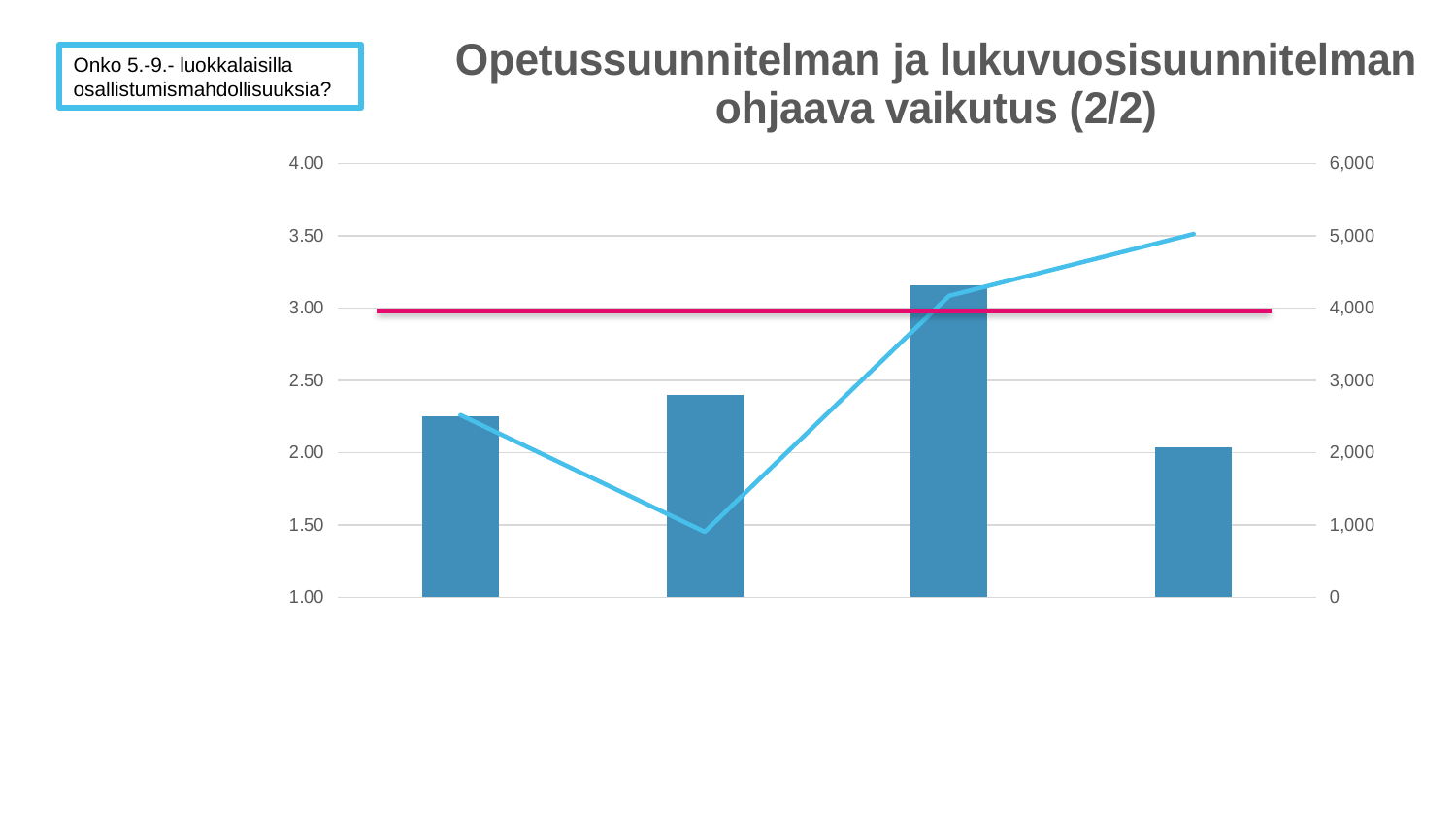
What kind of chart is shown on the slide? A bar chart combined with a line chart Which is taller, the second bar or the third bar from the left? The third bar Is the value of the second bar from the left greater or less than 3.00 on the left axis? less How many bars are plotted in the chart? 4 Is the value of the first bar from the left greater or less than 2.00 on the left axis? greater Is the value of the third bar from the left greater or less than 3.00 on the left axis? greater What is the title of the chart on the slide? Opetussuunnitelman ja lukuvuosisuunnitelman ohjaava vaikutus (2/2) Which bar is the tallest in the chart? The third bar from the left Which bar is the shortest in the chart? The fourth bar from the left At which position does the light blue line reach its lowest point? The second point from the left